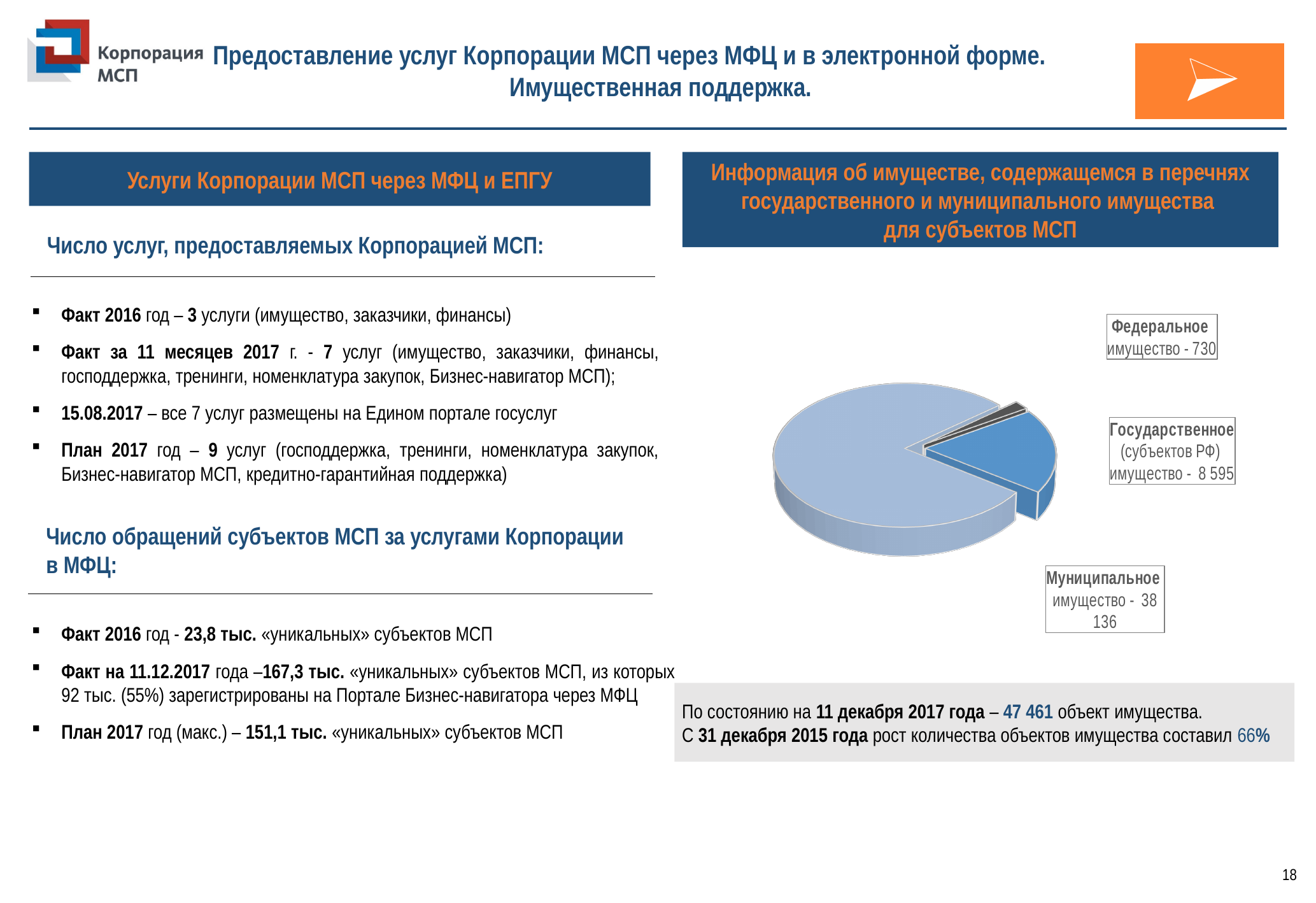
What kind of chart is shown on the slide? pie chart What is the difference between Муниципальное имущество and Государственное (субъектов РФ) имущество? 29 541 What is the value for Государственное (субъектов РФ) имущество in the pie chart? 8 595 Which category has the smallest slice in the pie chart? Федеральное имущество What is the value for Муниципальное имущество in the pie chart? 38 136 What is the value for Федеральное имущество in the pie chart? 730 Which category has the largest slice in the pie chart? Муниципальное имущество How many slices does the pie chart have? 3 What is the title of the section containing the pie chart? Информация об имуществе, содержащемся в перечнях государственного и муниципального имущества для субъектов МСП Which is larger: Государственное (субъектов РФ) имущество or Федеральное имущество? Государственное (субъектов РФ) имущество What is the difference between Государственное (субъектов РФ) имущество and Федеральное имущество? 7 865 What is the total of all three slices in the pie chart? 47 461